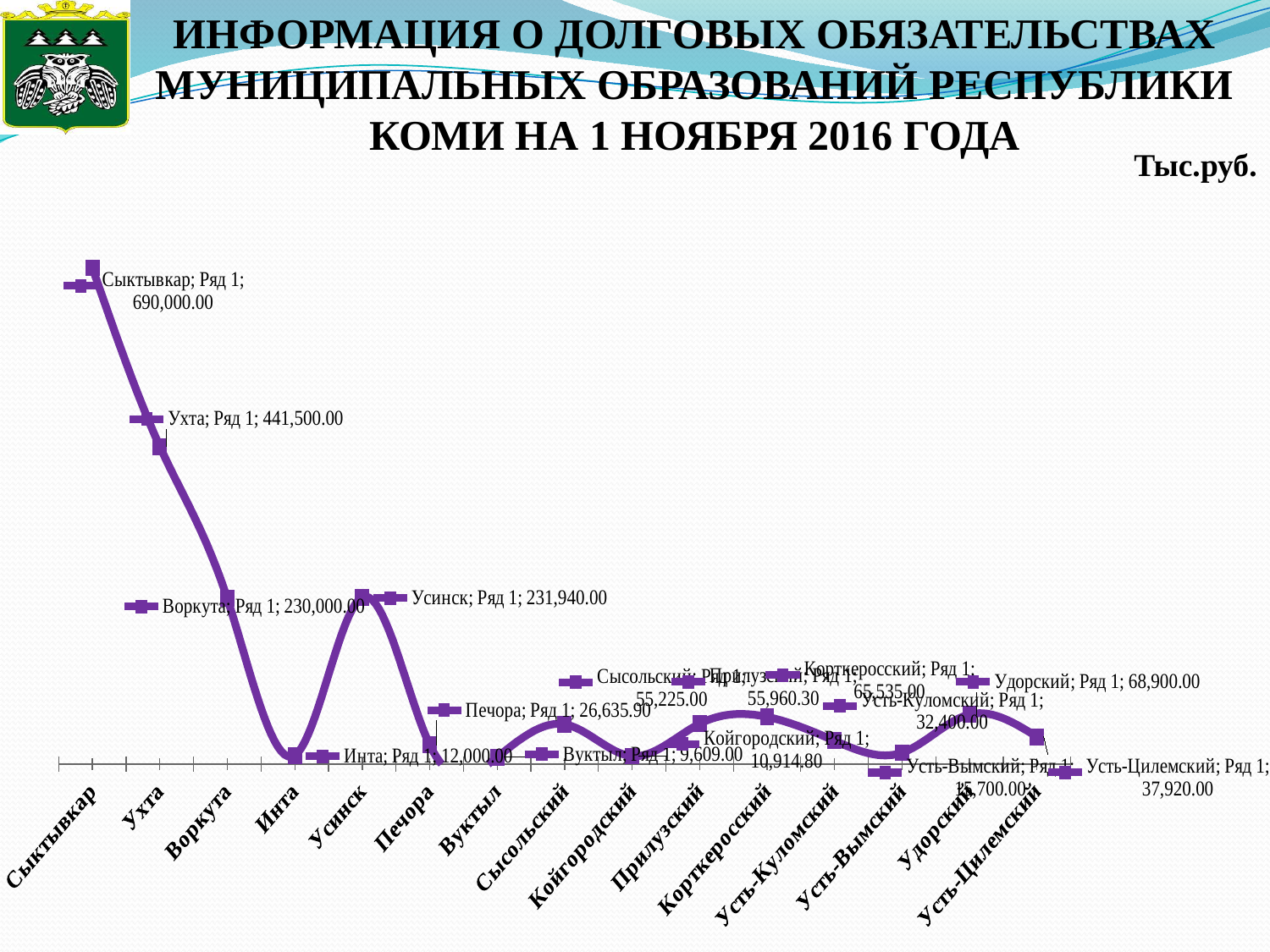
What is the value for Ухта? 441,500.00 Which is larger, the value for Ухта or the value for Воркута? Ухта How many municipalities are plotted on the chart? 15 What kind of chart is shown on the slide? line chart What is the value for Инта? 12,000.00 Which municipality has the highest value? Сыктывкар What is the value for Удорский? 68,900.00 Which municipality has the lowest value? Вуктыл In what units are the values on the chart expressed? Тыс.руб. What is the difference between the values for Сыктывкар and Ухта? 248,500.00 What is the value for Сыктывкар? 690,000.00 What is the value for Усинск? 231,940.00